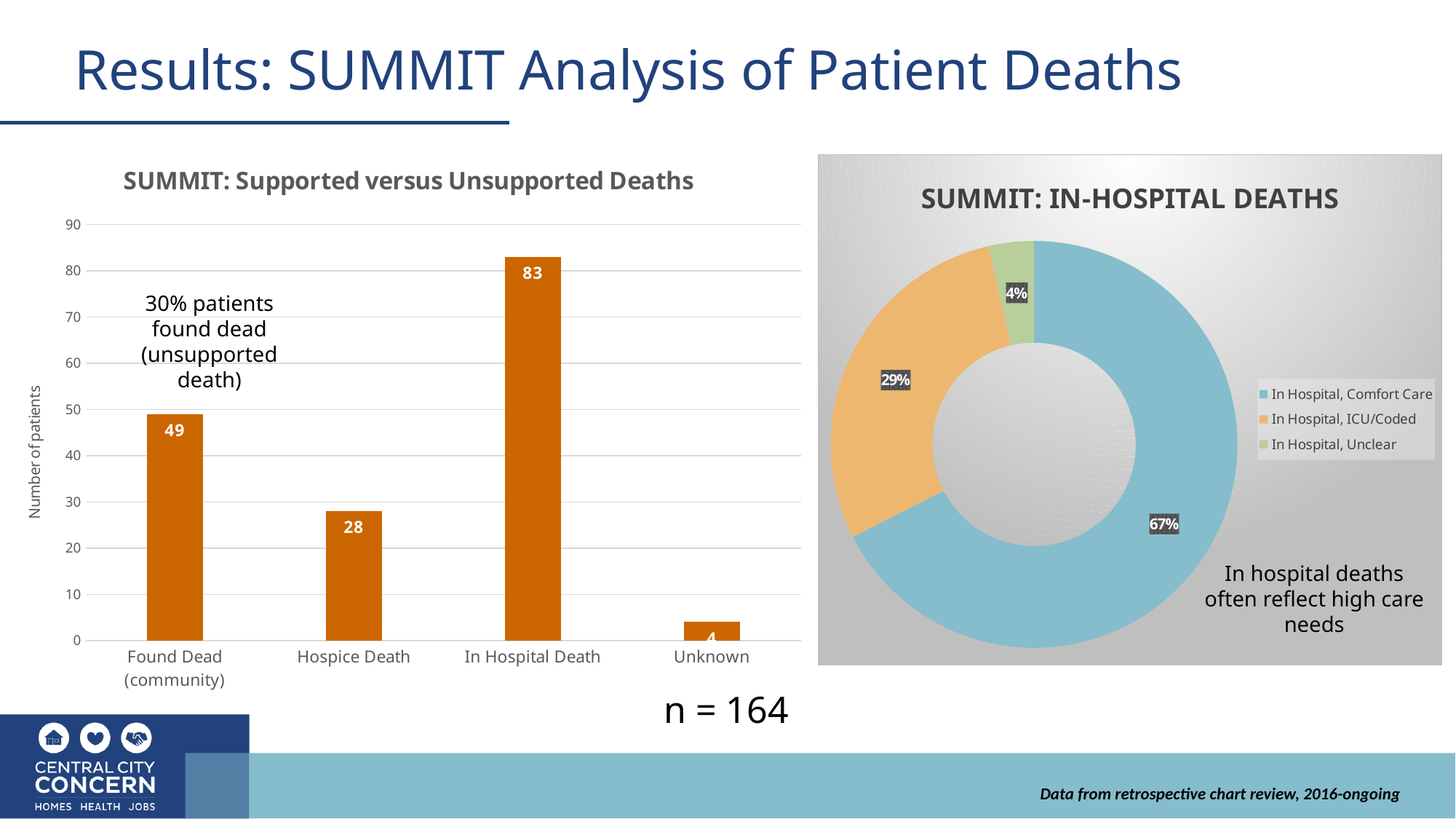
In the 'SUMMIT: Supported versus Unsupported Deaths' chart, what is the value for Hospice Death? 28 In the 'SUMMIT: Supported versus Unsupported Deaths' chart, what is the value for Found Dead (community)? 49 In the 'SUMMIT: Supported versus Unsupported Deaths' chart, what is the value for In Hospital Death? 83 In the 'SUMMIT: Supported versus Unsupported Deaths' chart, which category has the lowest value? Unknown In the 'SUMMIT: Supported versus Unsupported Deaths' chart, what is the difference between In Hospital Death and Found Dead (community)? 34 What kind of chart is 'SUMMIT: Supported versus Unsupported Deaths'? Bar chart In the 'SUMMIT: Supported versus Unsupported Deaths' chart, which is larger, Found Dead (community) or Hospice Death? Found Dead (community) How many entries does the legend of the 'SUMMIT: IN-HOSPITAL DEATHS' chart list? 3 In the 'SUMMIT: IN-HOSPITAL DEATHS' chart, what share is In Hospital, ICU/Coded? 29% In the 'SUMMIT: Supported versus Unsupported Deaths' chart, which category has the highest value? In Hospital Death In the 'SUMMIT: IN-HOSPITAL DEATHS' chart, what share is In Hospital, Comfort Care? 67% In the 'SUMMIT: Supported versus Unsupported Deaths' chart, how many categories are shown on the x axis? 4